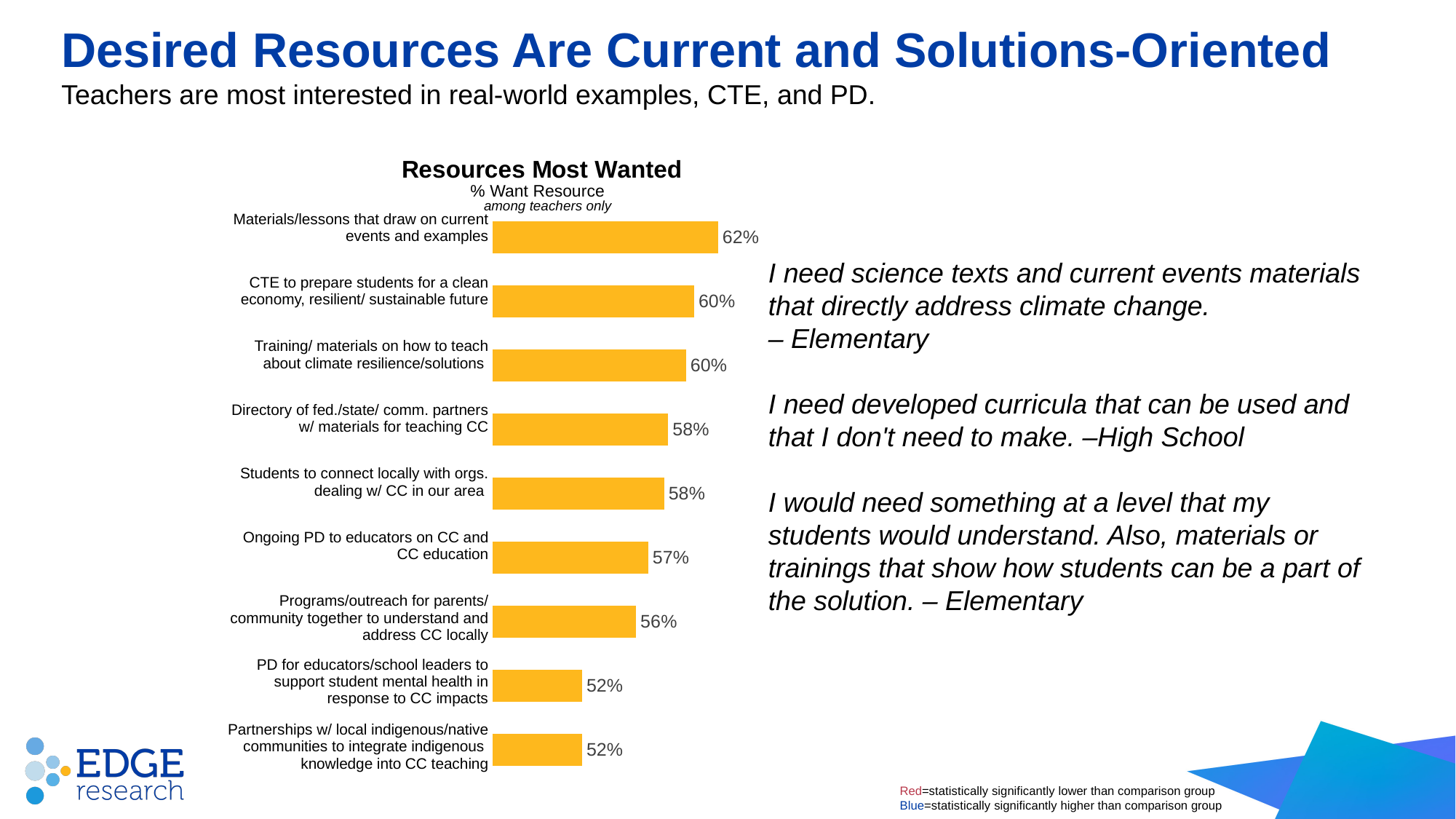
What percentage of teachers want materials/lessons that draw on current events and examples? 62% What type of chart is used to show the resources most wanted? Bar chart Which is larger: the value for 'Directory of fed./state/comm. partners w/ materials for teaching CC' or the value for 'Ongoing PD to educators on CC and CC education'? Directory of fed./state/comm. partners w/ materials for teaching CC Do the values rise or fall going from the top bar to the bottom bar? Fall What percentage want programs/outreach for parents/community together to understand and address CC locally? 56% What is the difference between the value for materials/lessons that draw on current events and the value for PD for educators/school leaders to support student mental health? 10 percentage points What is the value for 'Ongoing PD to educators on CC and CC education'? 57% What is the lowest value shown in the chart? 52% How many resource categories are shown in the chart? 9 Which resource has the highest percentage of teachers wanting it? Materials/lessons that draw on current events and examples What colour are the bars in the chart? Yellow/orange What is the title of the chart? Resources Most Wanted